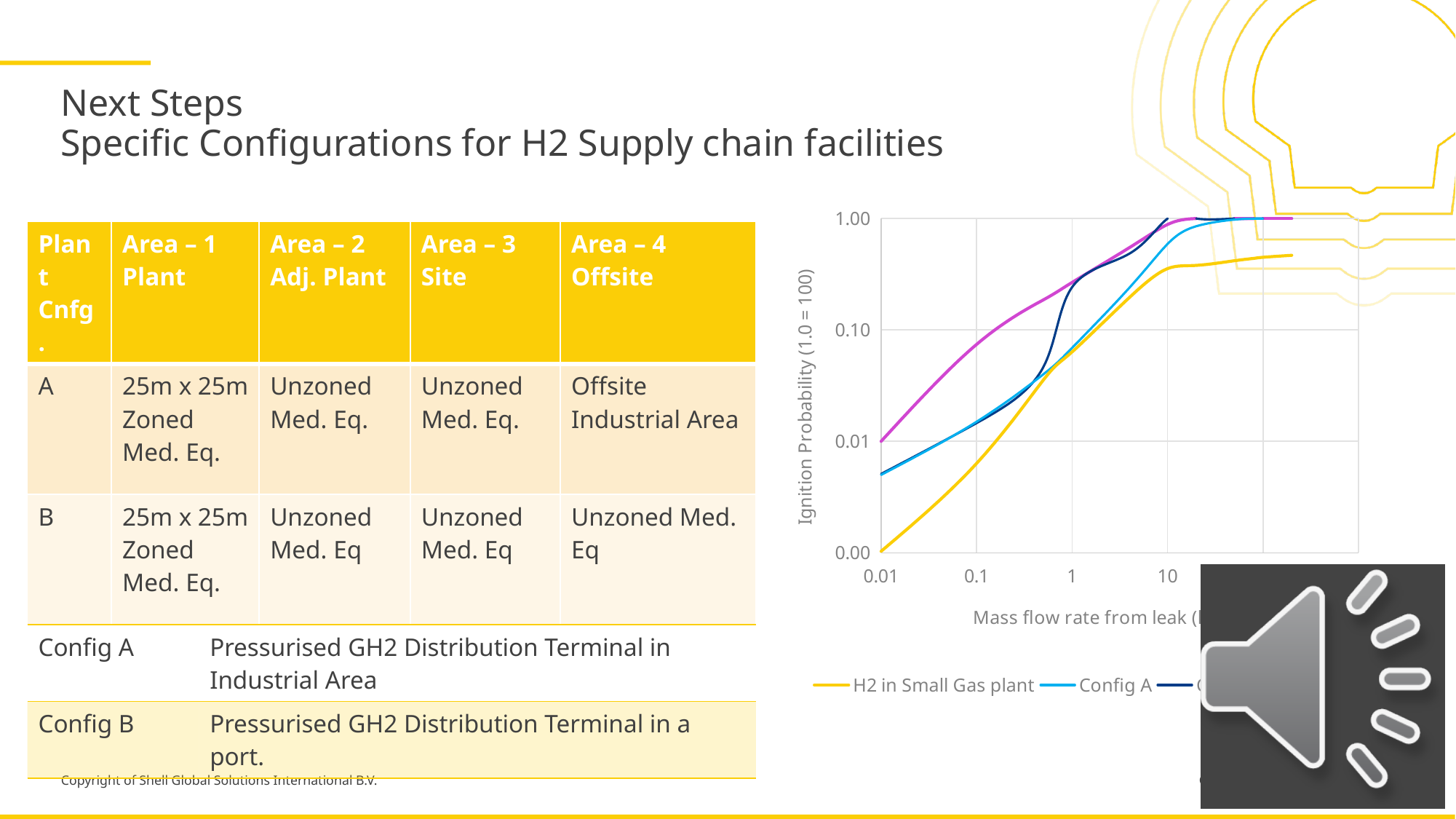
Which line is the lowest at the right-hand end of the chart (mass flow rate of 10)? H2 in Small Gas plant Is the value for 'H2 in Small Gas plant' at a mass flow rate of 0.01 greater or less than 0.01? less What kind of chart is shown on the slide? line chart Do the values of the 'Config A' line rise or fall as the mass flow rate increases along the x axis? rise Is the value for 'H2 in Small Gas plant' at a mass flow rate of 10 greater or less than 0.10? greater At a mass flow rate of 10, which line is higher: 'Config A' or 'H2 in Small Gas plant'? Config A What colour is the line for 'H2 in Small Gas plant' in the chart? yellow Do the values of the 'H2 in Small Gas plant' line rise or fall as the mass flow rate increases along the x axis? rise Is the value for 'H2 in Small Gas plant' at a mass flow rate of 1 greater or less than 0.10? less What is the label of the y axis of the chart? Ignition Probability (1.0 = 100) At a mass flow rate of 0.01, which line is higher: 'Config A' or 'H2 in Small Gas plant'? Config A